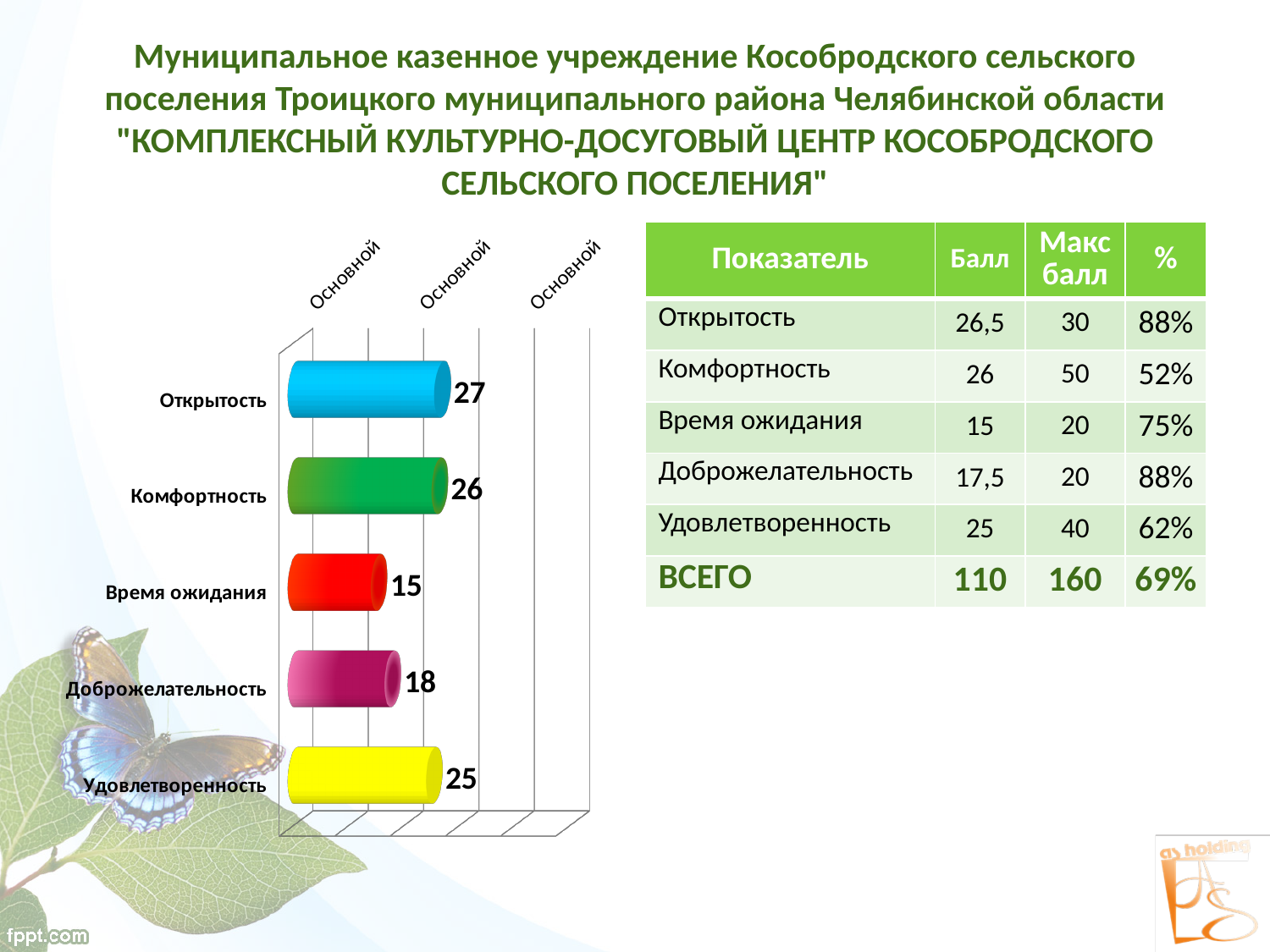
What colour is the bar for Удовлетворенность in the chart? Yellow Which category has the lowest value in the chart? Время ожидания Which is larger in the chart, the value for Комфортность or the value for Доброжелательность? Комфортность What kind of chart is shown on the slide? Bar chart What value is shown for Удовлетворенность in the chart? 25 What is the difference between the values for Открытость and Время ожидания in the chart? 12 How many categories are plotted in the chart? 5 What value is shown for Доброжелательность in the chart? 18 Which category has the highest value in the chart? Открытость What is the difference between the values for Удовлетворенность and Доброжелательность in the chart? 7 What value is shown for Открытость in the chart? 27 What value is shown for Время ожидания in the chart? 15